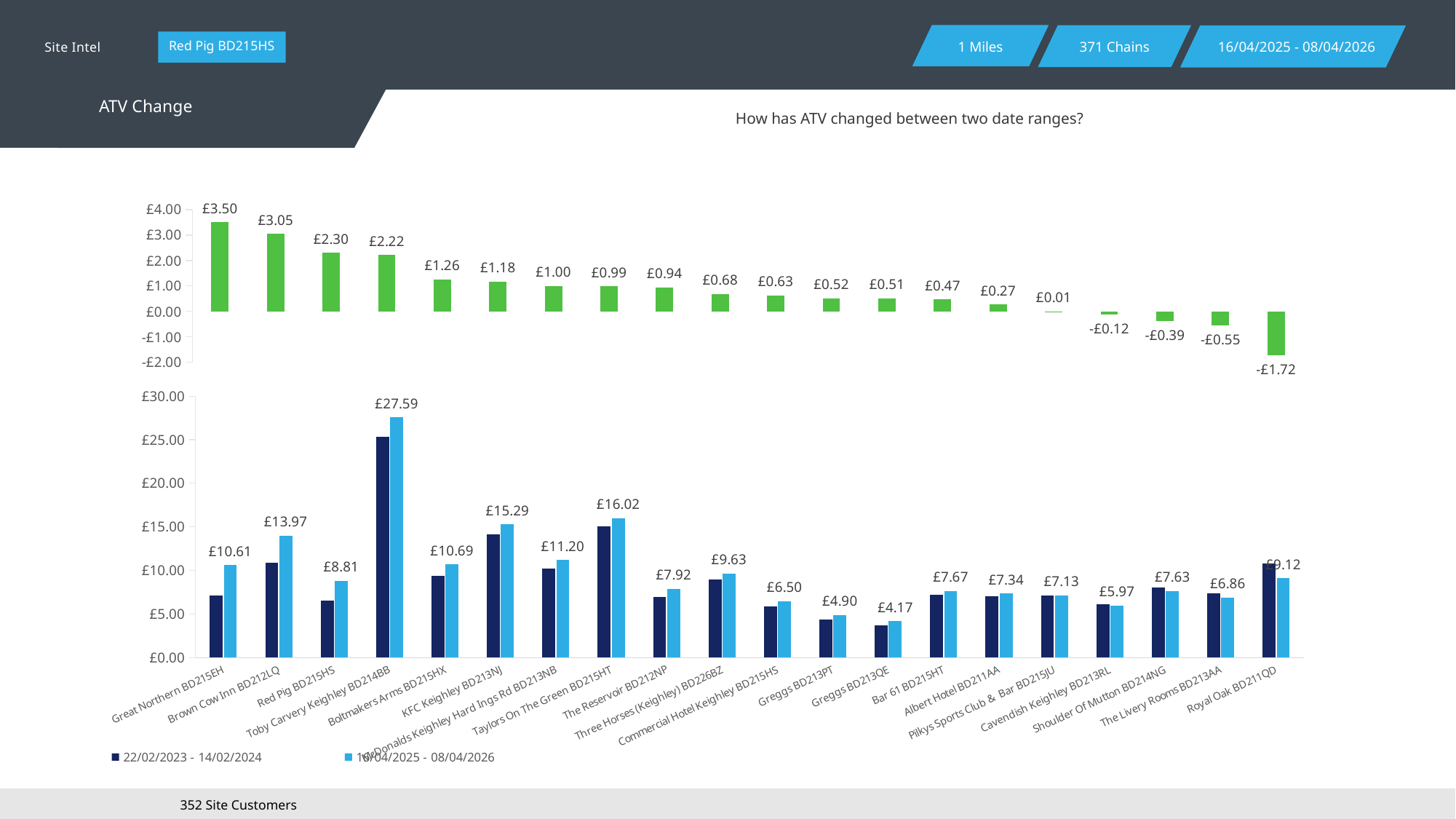
In the bottom chart, what is the difference between the 16/04/2025 - 08/04/2026 values for Toby Carvery Keighley BD214BB and Taylors On The Green BD215HT? £11.57 In the bottom chart, what is the value for Greggs BD213QE in the 16/04/2025 - 08/04/2026 series? £4.17 In the bottom chart, which venue has the highest value in the 16/04/2025 - 08/04/2026 series? Toby Carvery Keighley BD214BB In the bottom chart, which has the larger 16/04/2025 - 08/04/2026 value: Brown Cow Inn BD212LQ or Red Pig BD215HS? Brown Cow Inn BD212LQ In the top chart, what is the highest value shown? £3.50 In the bottom chart, which venue has the lowest value in the 16/04/2025 - 08/04/2026 series? Greggs BD213QE How many series does the legend of the bottom chart list? 2 In the bottom chart, is the 22/02/2023 - 14/02/2024 value for Great Northern BD215EH greater or less than £10.00? less In the bottom chart, what is the value for Toby Carvery Keighley BD214BB in the 16/04/2025 - 08/04/2026 series? £27.59 In the top chart, do the values rise or fall from left to right? fall What kind of chart is the bottom chart on the slide? bar chart How many venues are shown on the x axis of the bottom chart? 20